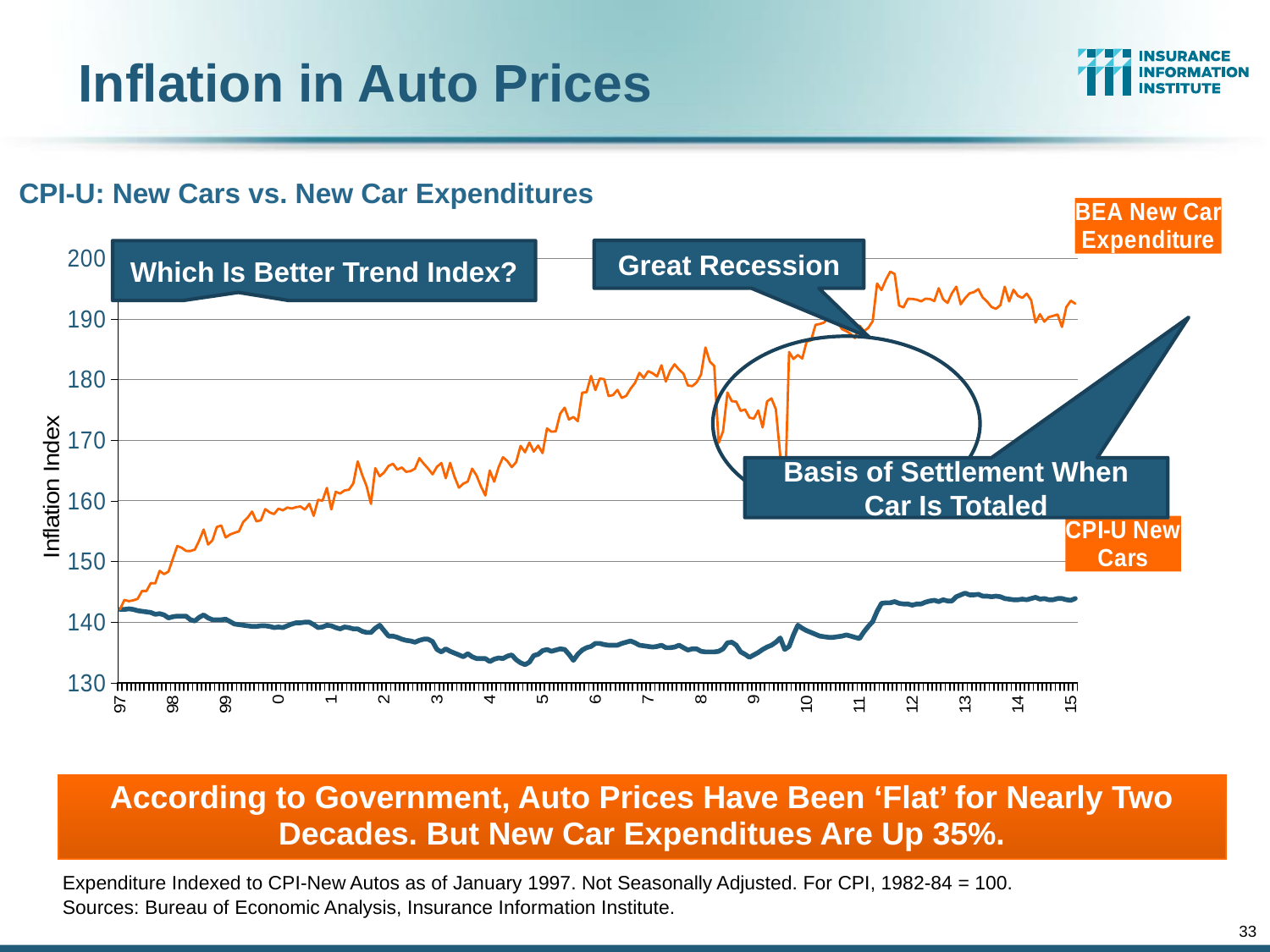
Which series has the higher value in 2014, BEA New Car Expenditure or CPI-U New Cars? BEA New Car Expenditure Is the value of CPI-U New Cars in 2005 greater or less than 140? less What kind of chart is shown on the slide? Line chart Is the value of BEA New Car Expenditure in 2014 greater or less than 180? greater Is the value of BEA New Car Expenditure at the start of 1997 greater or less than 150? less What is the label on the vertical axis of the chart? Inflation Index Which series is plotted in blue? CPI-U New Cars What is the title of the chart? CPI-U: New Cars vs. New Car Expenditures How many data series are plotted on the chart? 2 Does the BEA New Car Expenditure series generally rise or fall from 1997 to 2015? Rise